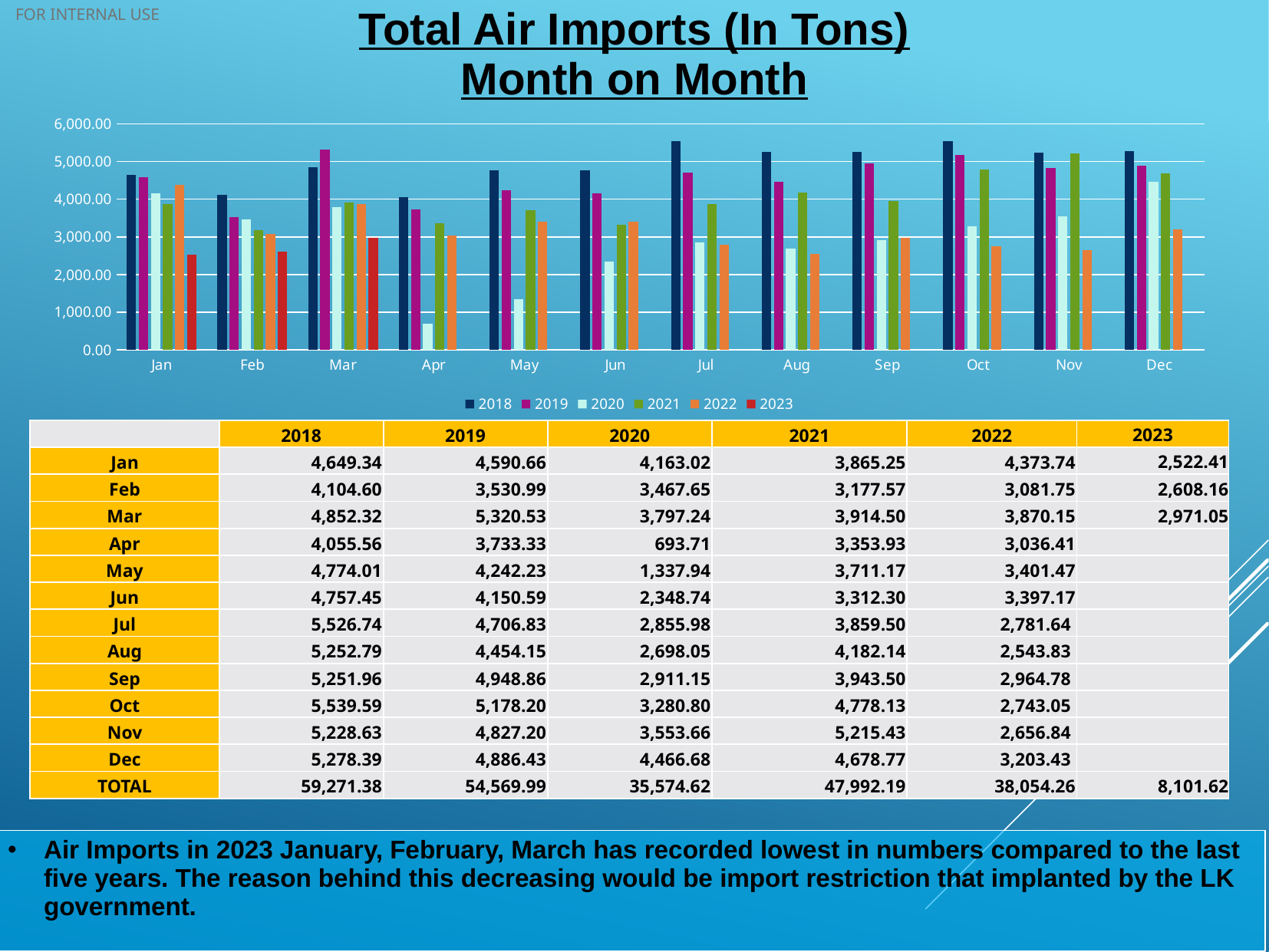
In Mar, which is larger: the value for 2018 or the value for 2019? 2019 Which month has the highest value for 2018? Oct What is the value for 2021 in Nov? 5,215.43 Which month has the lowest value for 2020? Apr What is the value for 2018 in Jan? 4,649.34 What kind of chart is shown on the slide? bar chart Is the value for 2018 in Jul greater or less than 5,000.00? greater How many months are shown along the x axis of the chart? 12 Do the 2023 values rise or fall from Jan to Mar? rise What is the difference between the Jan values for 2018 and 2023? 2,126.93 How many series does the chart legend list? 6 What is the value for 2020 in Apr? 693.71